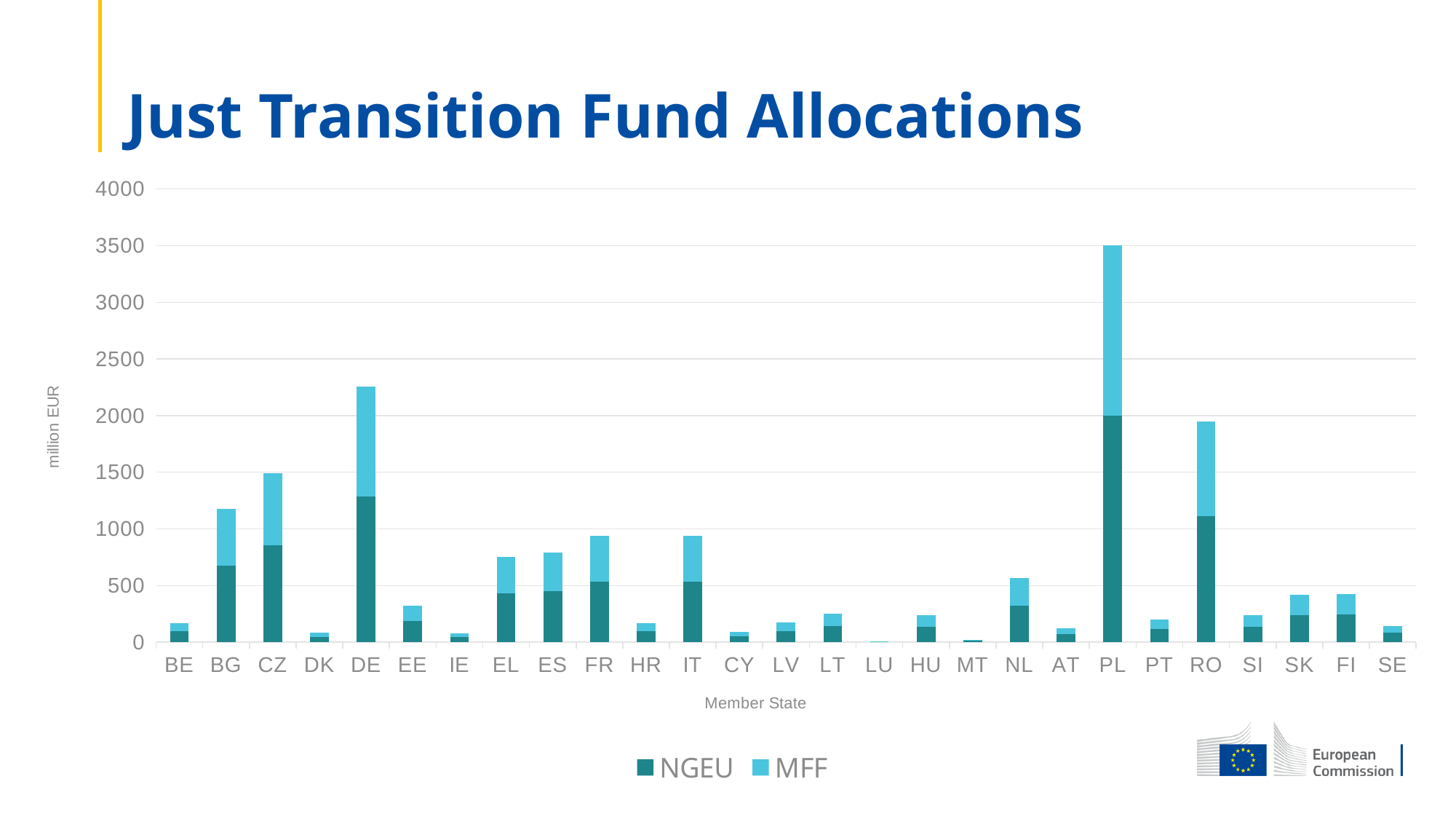
What kind of chart is shown on the slide? bar chart Is the total allocation for DE greater or less than 2000? greater What is the label on the vertical axis? million EUR Is the total allocation for PL greater or less than 3000? greater Which member state has the highest total allocation? PL Which has a larger total allocation, DE or RO? DE How many series does the legend list? 2 How many member states are shown on the x axis? 27 Is the total allocation for IT greater or less than 1000? less Which member state has the lowest total allocation? LU What are the two series named in the legend? NGEU and MFF